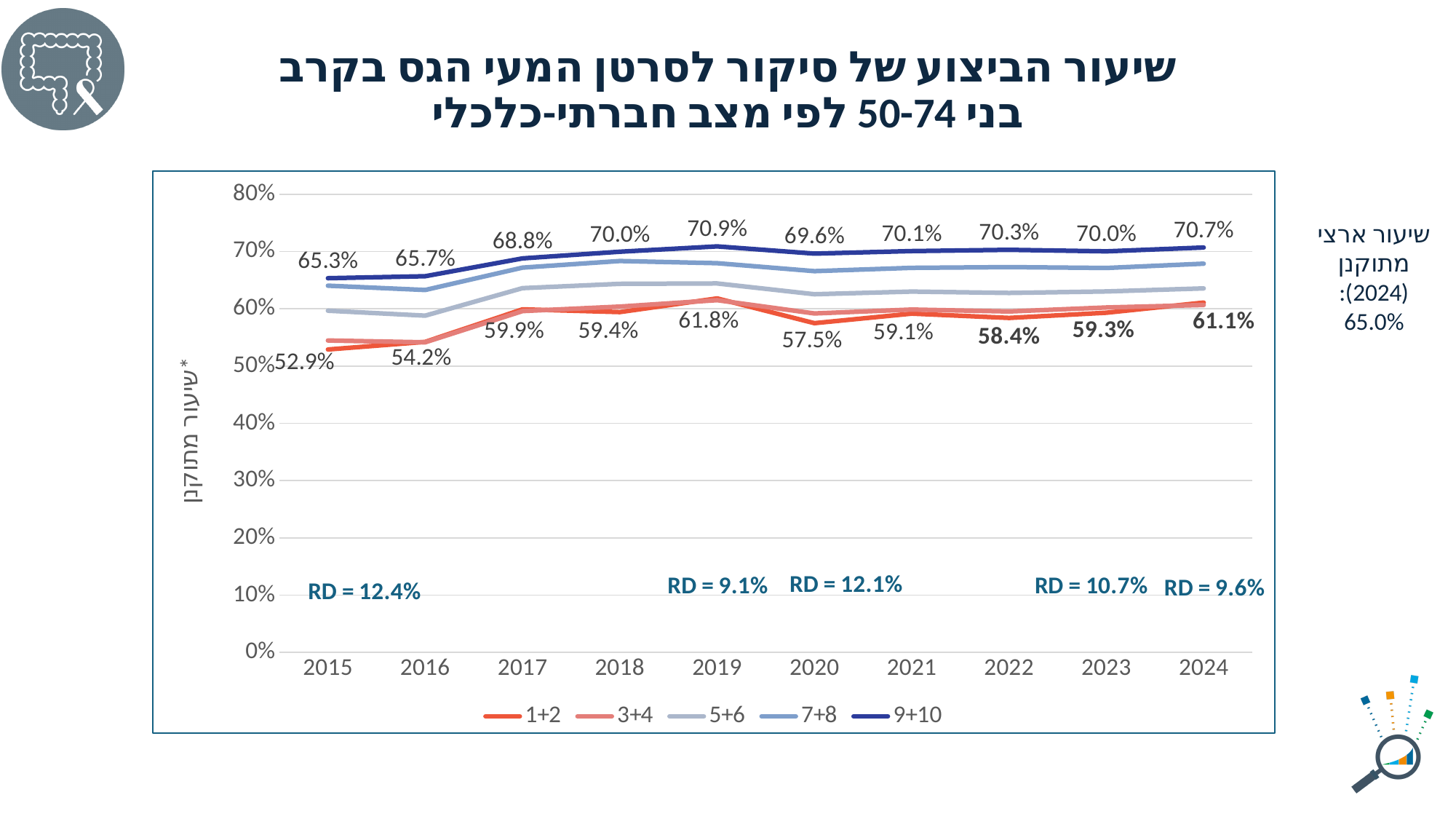
In which year is the 1+2 series at its lowest value? 2015 Which is larger: the 1+2 value in 2019 or the 1+2 value in 2024? 2019 What is the difference between the 9+10 and 1+2 series in 2015? 12.4% In which year does the 9+10 series reach its highest value? 2019 What is the value for the 9+10 series in 2019? 70.9% What is the value for the 1+2 series in 2020? 57.5% How many series does the legend list? 5 Does the 1+2 series rise or fall from 2015 to 2017? rise Is the value for the 7+8 series in 2024 greater or less than 60%? greater How many years are shown on the x axis? 10 What type of chart is shown on the slide? line chart What is the value for the 1+2 series in 2024? 61.1%